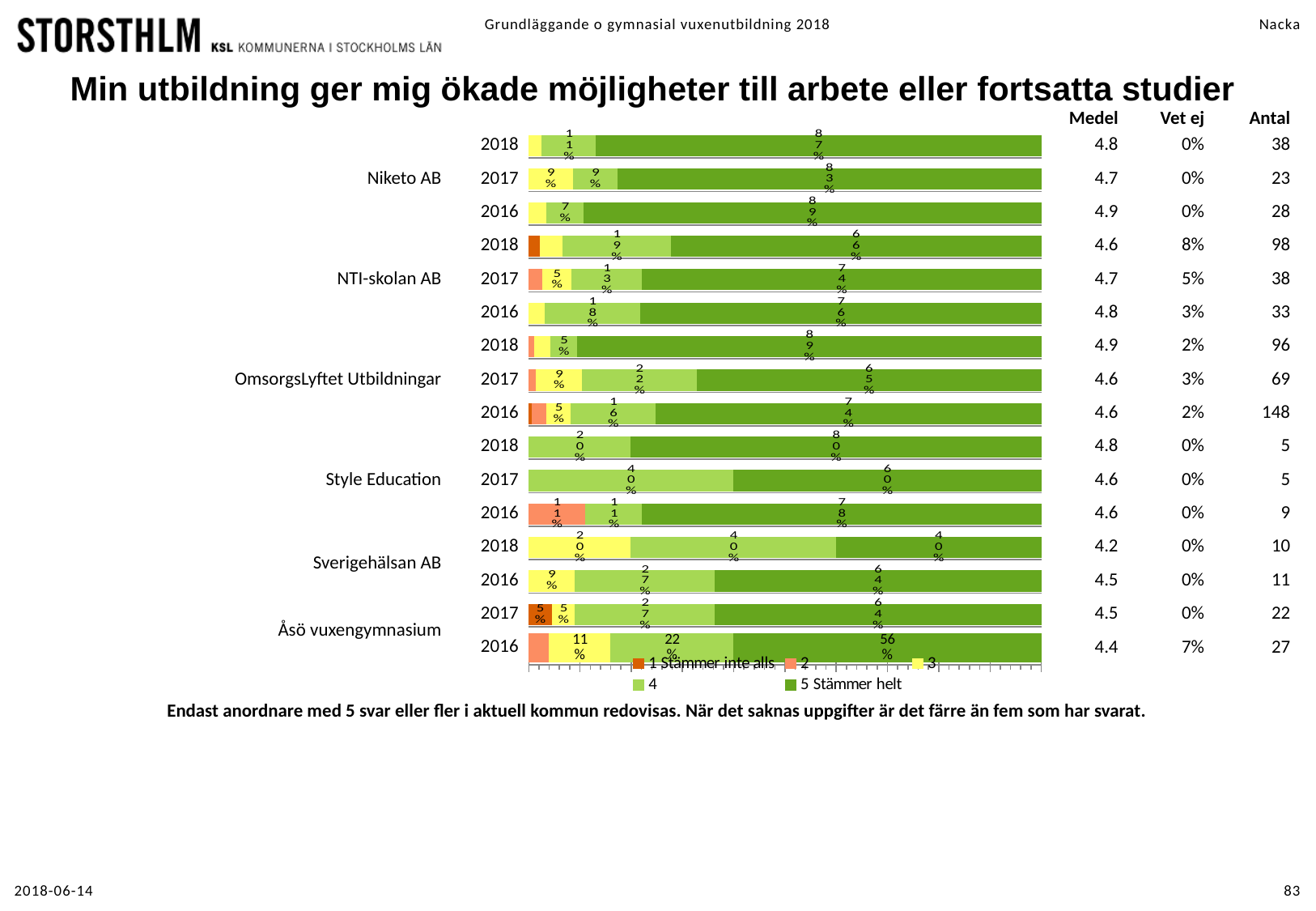
What is the label of the first legend entry? 1 Stämmer inte alls What is the value of '5 Stämmer helt' for Åsö vuxengymnasium in 2016? 56% How many series does the legend list? 5 What is the value of '5 Stämmer helt' for Niketo AB in 2016? 89% Which is larger: '5 Stämmer helt' for Niketo AB 2018 or '5 Stämmer helt' for Style Education 2017? Niketo AB 2018 What is the value of '4' for Style Education in 2017? 40% Which bar has the lowest value for '5 Stämmer helt'? Sverigehälsan AB 2018 How many bars are plotted in the chart? 16 What is the value of '3' for Sverigehälsan AB in 2018? 20% What is the difference between '5 Stämmer helt' and '4' for Åsö vuxengymnasium in 2016? 34 percentage points What kind of chart is shown on the slide? bar chart What is the title of the chart? Min utbildning ger mig ökade möjligheter till arbete eller fortsatta studier